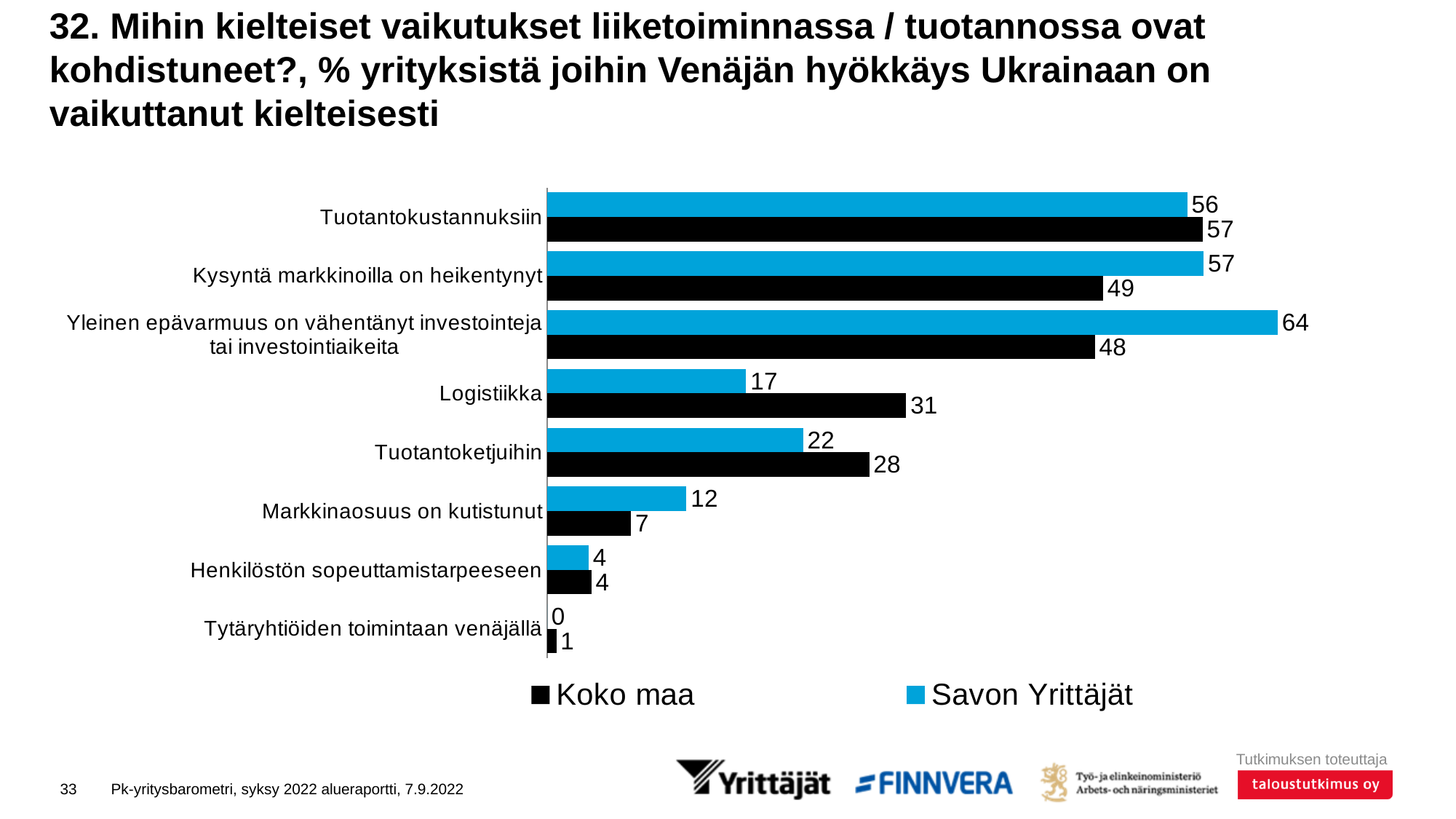
Which series has the larger value for Tuotantoketjuihin, Koko maa or Savon Yrittäjät? Koko maa Which category has the lowest value for Koko maa? Tytäryhtiöiden toimintaan venäjällä Which category has the highest value for Savon Yrittäjät? Yleinen epävarmuus on vähentänyt investointeja tai investointiaikeita How many categories are shown in the chart? 8 What is the value for Koko maa for Logistiikka? 31 What is the value for Koko maa for Kysyntä markkinoilla on heikentynyt? 49 What is the difference between the Savon Yrittäjät and Koko maa values for Yleinen epävarmuus on vähentänyt investointeja tai investointiaikeita? 16 How many series does the legend list? 2 What kind of chart is shown on the slide? Bar chart Which series has the larger value for Markkinaosuus on kutistunut, Koko maa or Savon Yrittäjät? Savon Yrittäjät What is the value for Savon Yrittäjät for Tuotantokustannuksiin? 56 What is the difference between the Koko maa and Savon Yrittäjät values for Logistiikka? 14